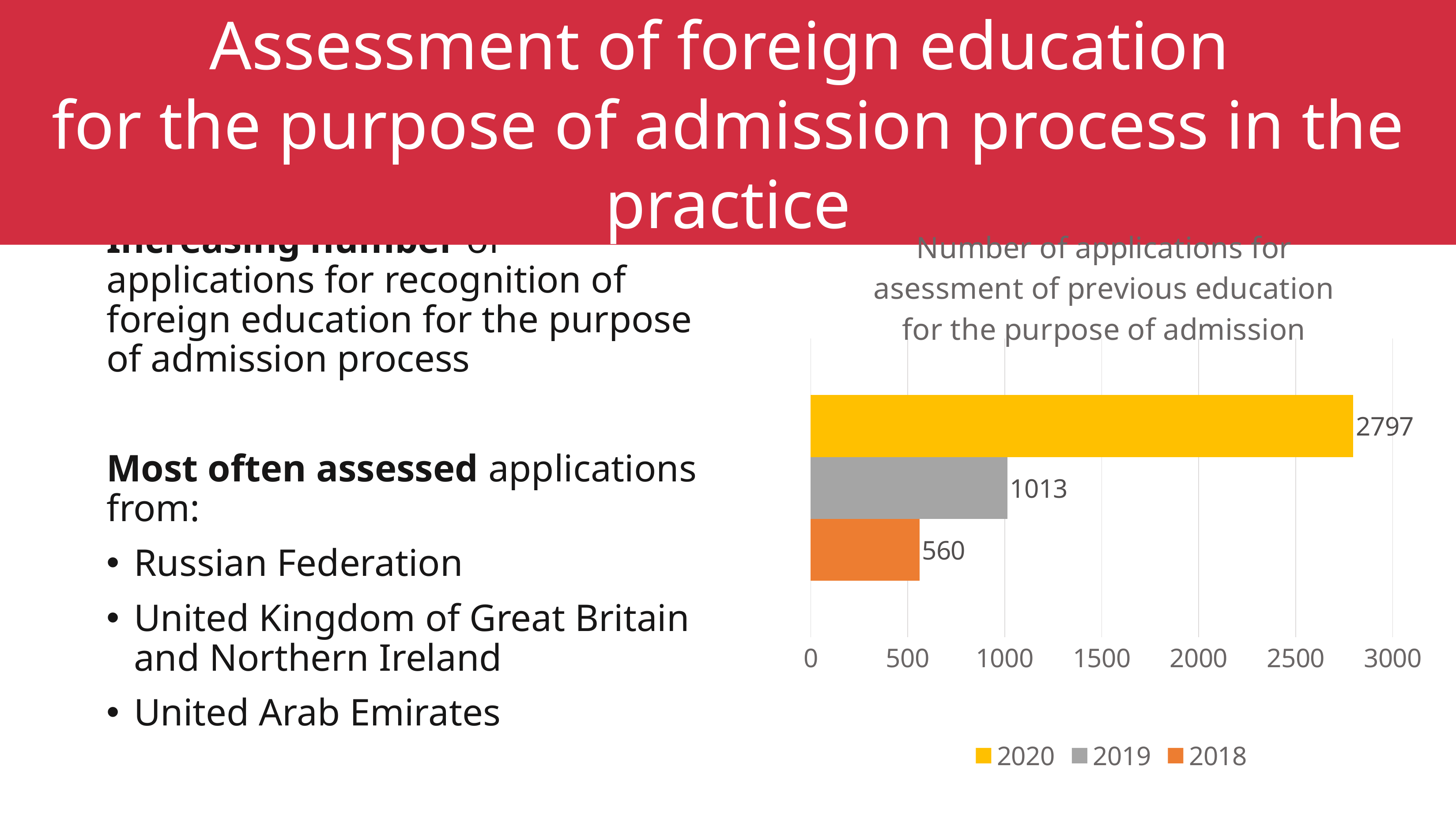
How many series does the legend list? 3 What is the difference between the number of applications in 2019 and 2018? 453 Which year has the highest number of applications? 2020 Which colour represents 2019 in the chart? Grey What kind of chart is shown on the slide? Bar chart What is the number of applications for 2020? 2797 What is the number of applications for 2018? 560 What is the number of applications for 2019? 1013 Is the value for 2020 greater or less than 2500? greater Which year has the lowest number of applications? 2018 Which year had more applications, 2019 or 2018? 2019 What is the difference between the number of applications in 2020 and 2019? 1784